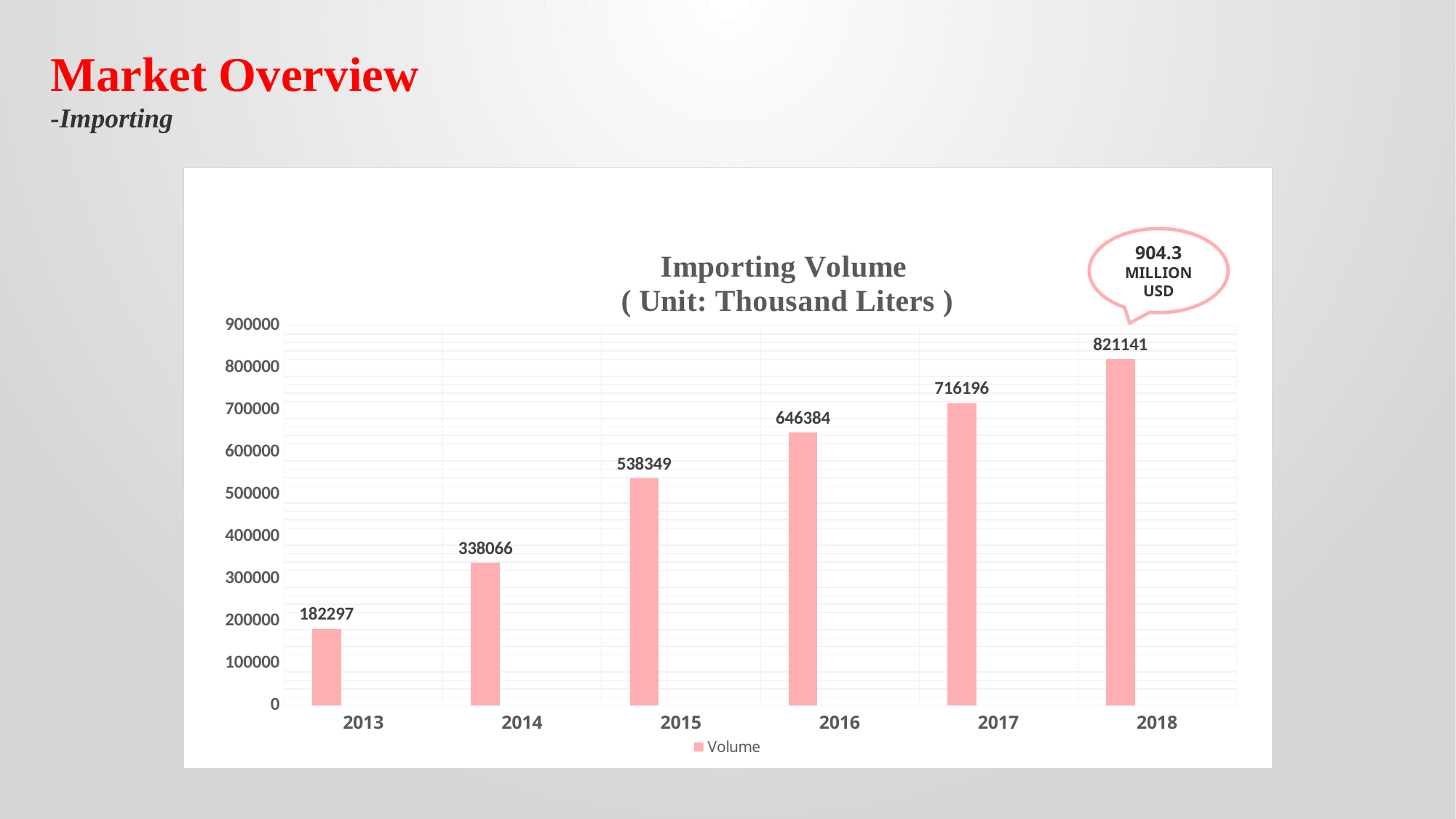
Does the importing volume rise or fall from 2013 to 2018? Rise What is the difference in importing volume between 2017 and 2016? 69812 Which year has the lowest importing volume? 2013 Is the importing volume for 2017 greater or less than 700000? greater What is the importing volume for 2013? 182297 Which year has a larger importing volume, 2014 or 2016? 2016 How many years are shown on the x axis of the chart? 6 What is the difference in importing volume between 2018 and 2013? 638844 What type of chart is used to show the importing volume? Bar chart What is the importing volume for 2015? 538349 What is the importing volume for 2018? 821141 Which year has the highest importing volume? 2018